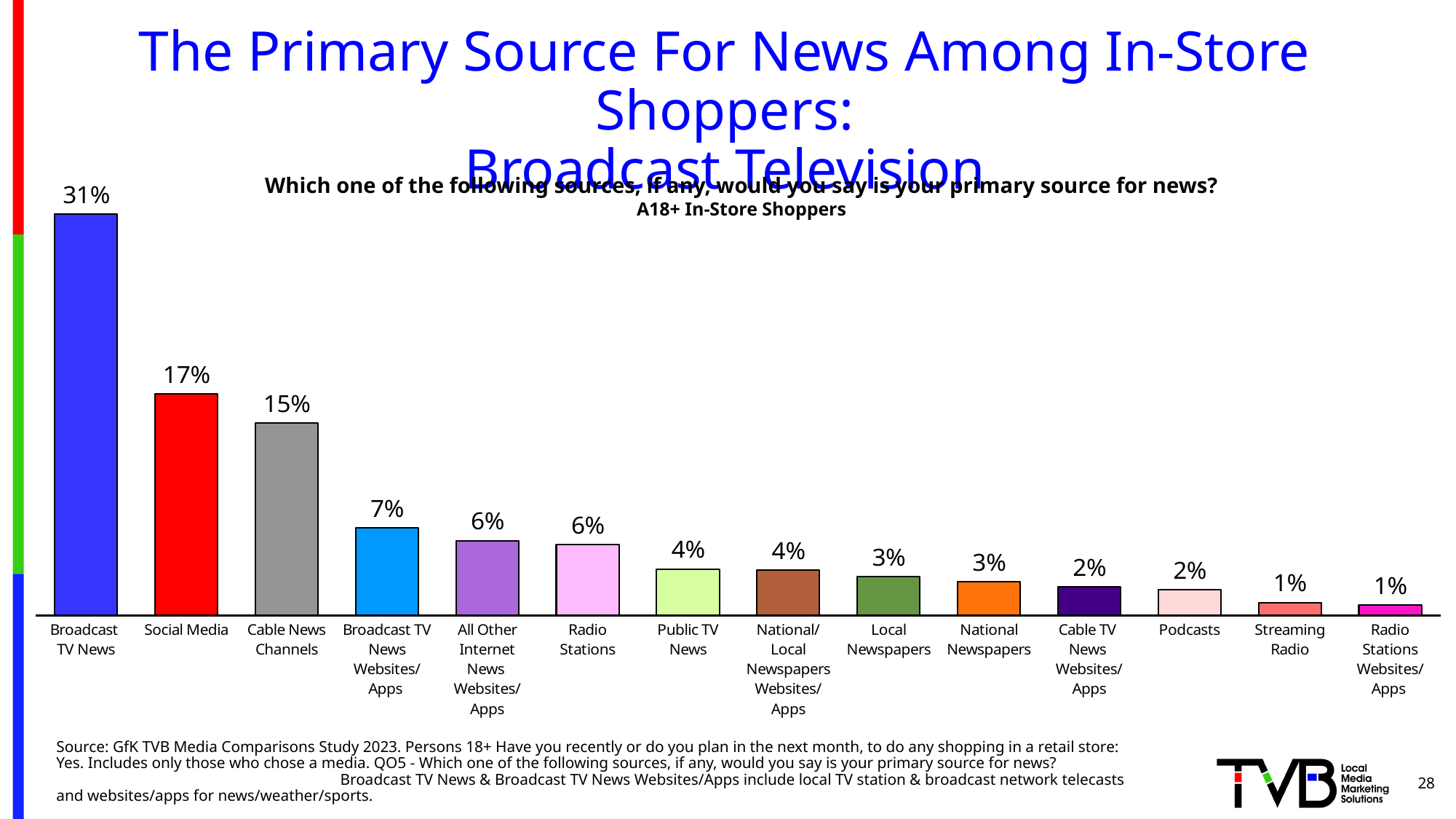
Which is larger, Public TV News or Local Newspapers? Public TV News How many categories are shown in the chart? 14 What is the value for Cable News Channels? 15% Which category has the highest value? Broadcast TV News What is the value for Podcasts? 2% What is the difference between Cable News Channels and Broadcast TV News Websites/Apps? 8% What kind of chart is shown on the slide? Bar chart What is the value for Social Media? 17% What is the value for Broadcast TV News? 31% Which is larger, Social Media or Cable News Channels? Social Media What audience is named in the chart subtitle? A18+ In-Store Shoppers What is the difference between Broadcast TV News and Social Media? 14%